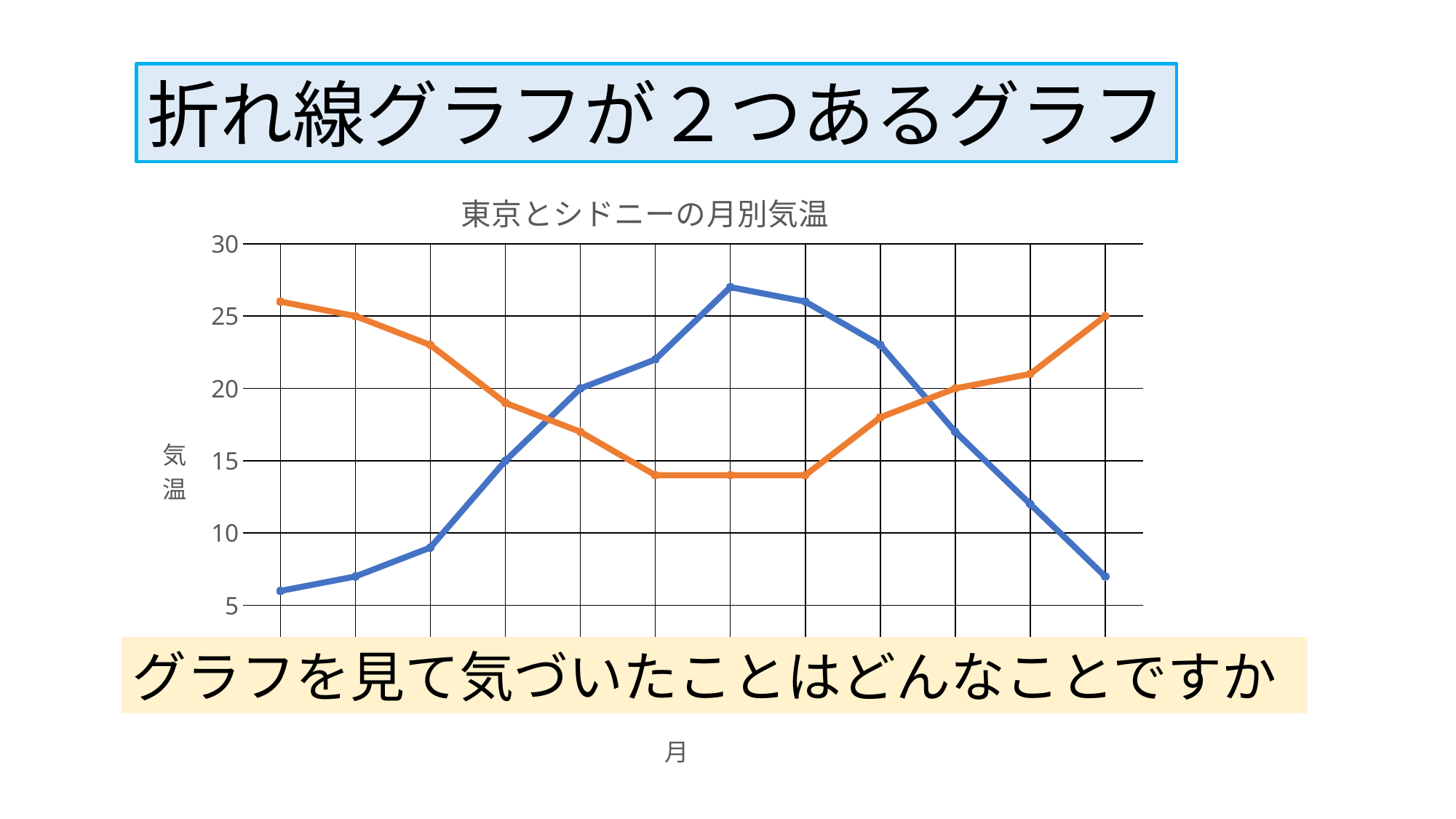
How many lines are plotted on the chart? 2 What value does the rightmost point of the orange line reach? 25 How many data points does the blue line have? 12 Is the leftmost point of the blue line greater or less than 10? less What type of chart is shown on the slide? line chart At the rightmost point, which line is higher, the blue line or the orange line? orange line Is the leftmost point of the orange line greater or less than 25? greater Is the highest point of the blue line greater or less than 25? greater Which line reaches the lowest value on the chart, the blue line or the orange line? blue line What is the label on the vertical axis of the chart? 気温 What is the title of the chart? 東京とシドニーの月別気温